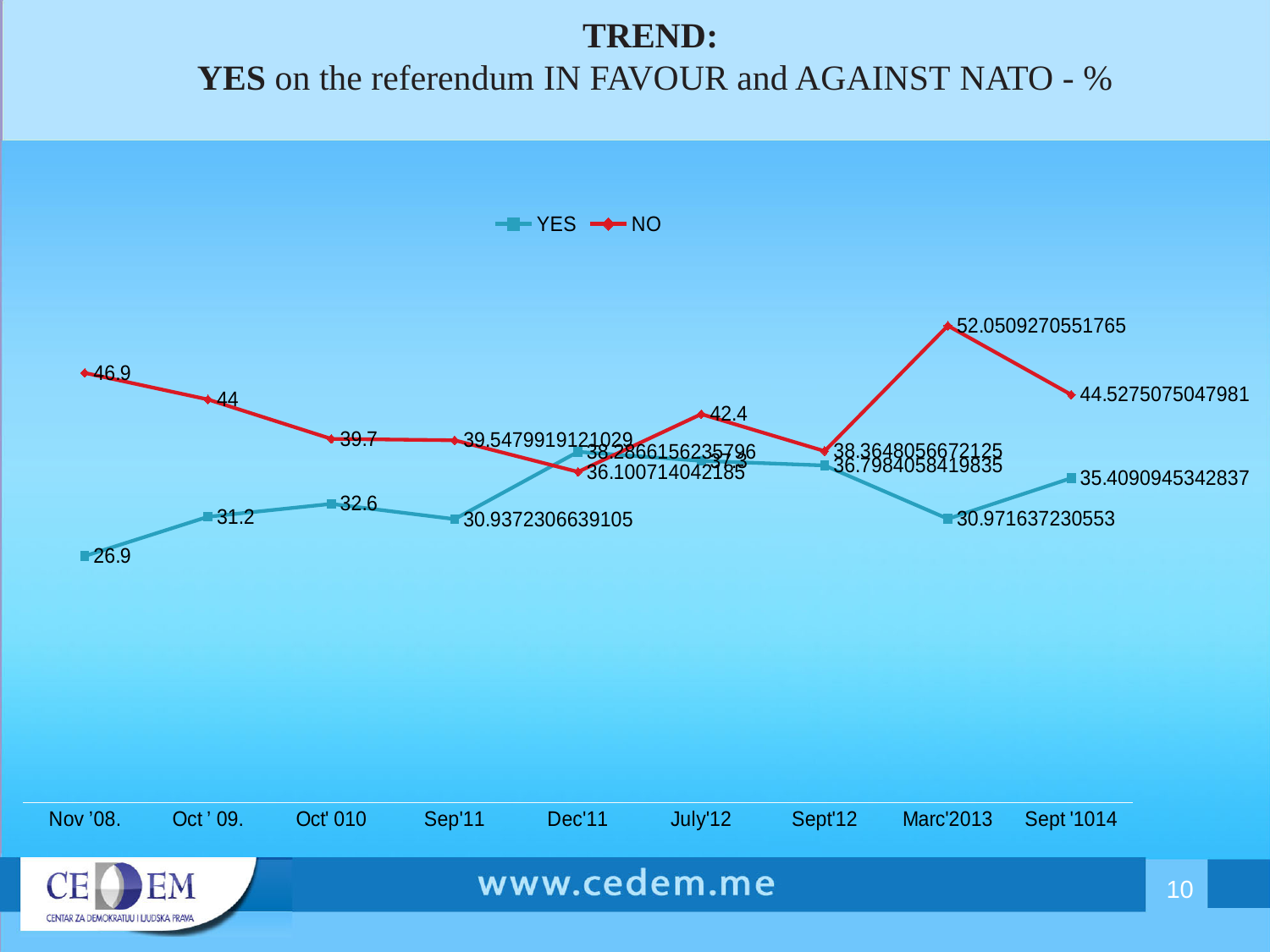
How many time points are shown on the x axis? 9 What is the NO value for July'12? 42.4 What kind of chart is shown on the slide? line chart What is the difference between the NO and YES values for Nov '08? 20 What is the NO value for Marc'2013? 52.0509270551765 What is the YES value for Oct' 010? 32.6 For Oct ' 09, which series has the larger value, YES or NO? NO How many series does the legend list? 2 At which time point is the YES series lowest? Nov '08 What is the NO value for Nov '08? 46.9 What is the YES value for Nov '08? 26.9 At which time point is the NO series highest? Marc'2013